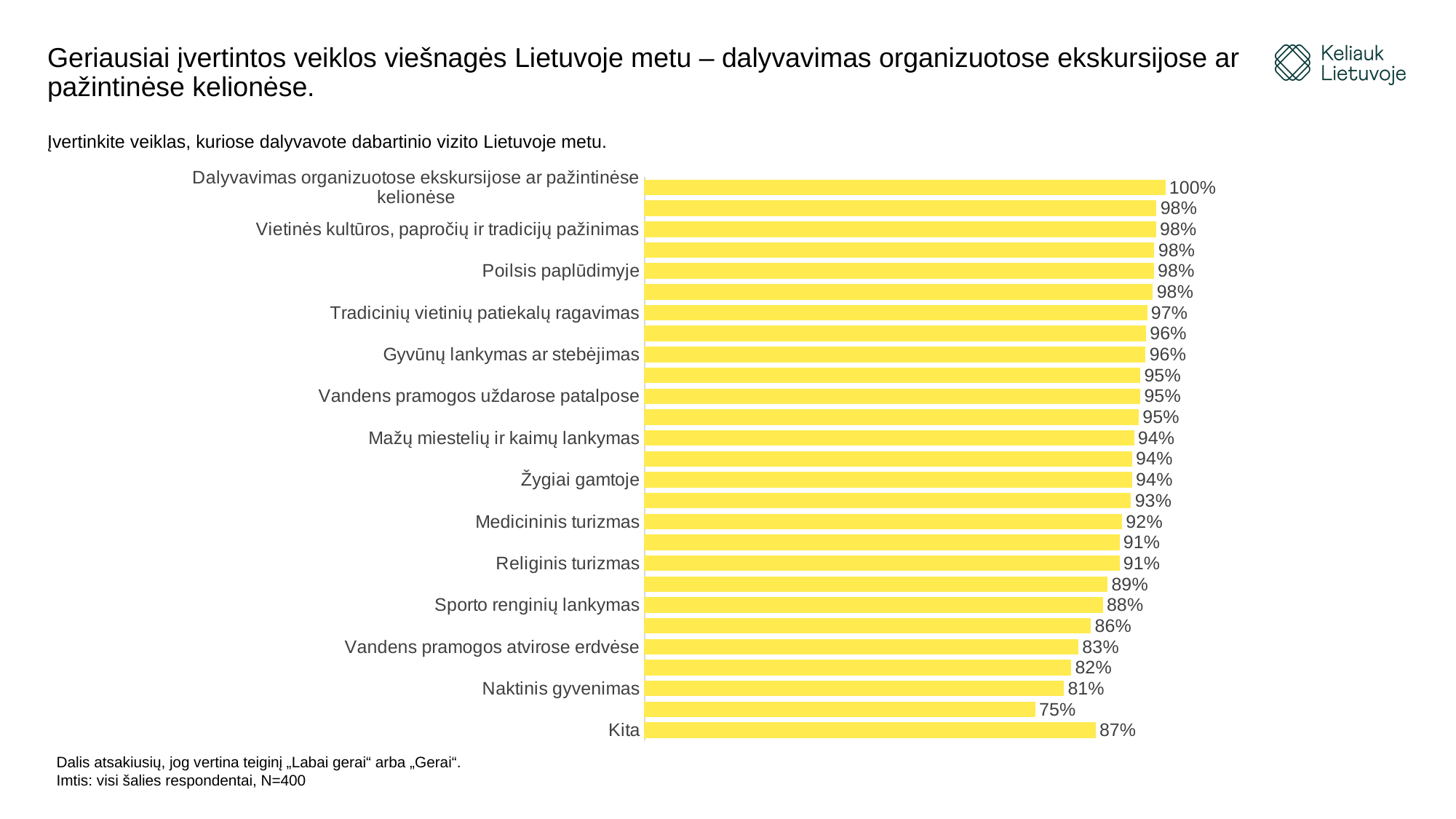
What kind of chart is shown on the slide? Bar chart Which is larger, the value for Sporto renginių lankymas or for Vandens pramogos atvirose erdvėse? Sporto renginių lankymas How many bars are plotted on the chart? 27 What is the difference between the values for Kita and Naktinis gyvenimas? 6 percentage points What is the value for Naktinis gyvenimas? 81% What is the value for Dalyvavimas organizuotose ekskursijose ar pažintinėse kelionėse? 100% What is the value for Kita? 87% What colour are the bars in the chart? Yellow Which labelled category has the highest value? Dalyvavimas organizuotose ekskursijose ar pažintinėse kelionėse What is the value for Medicininis turizmas? 92% What is the value for Vandens pramogos atvirose erdvėse? 83% What is the lowest value shown on the chart? 75%